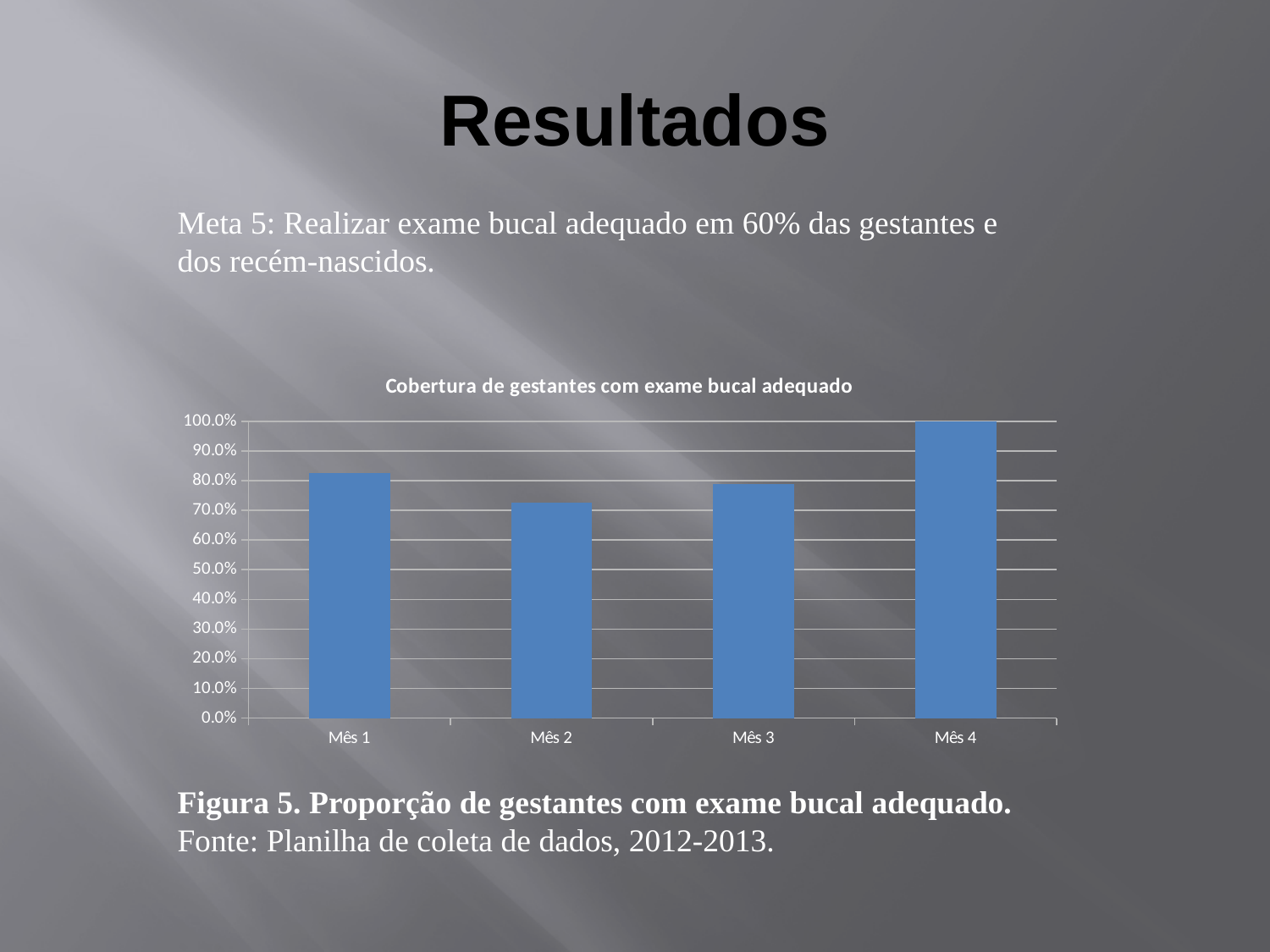
What is the title of the chart? Cobertura de gestantes com exame bucal adequado Does the value rise or fall from Mês 3 to Mês 4? rise Is the value for Mês 3 greater or less than 60.0%? greater Is the value for Mês 2 greater or less than 80.0%? less Is the value for Mês 1 greater or less than 90.0%? less Which is larger, the value for Mês 1 or the value for Mês 2? Mês 1 What type of chart is shown on the slide? bar chart Which month has the lowest value in the chart? Mês 2 What is the value for Mês 4? 100.0% How many categories (months) are plotted in the chart? 4 Which month has the highest value in the chart? Mês 4